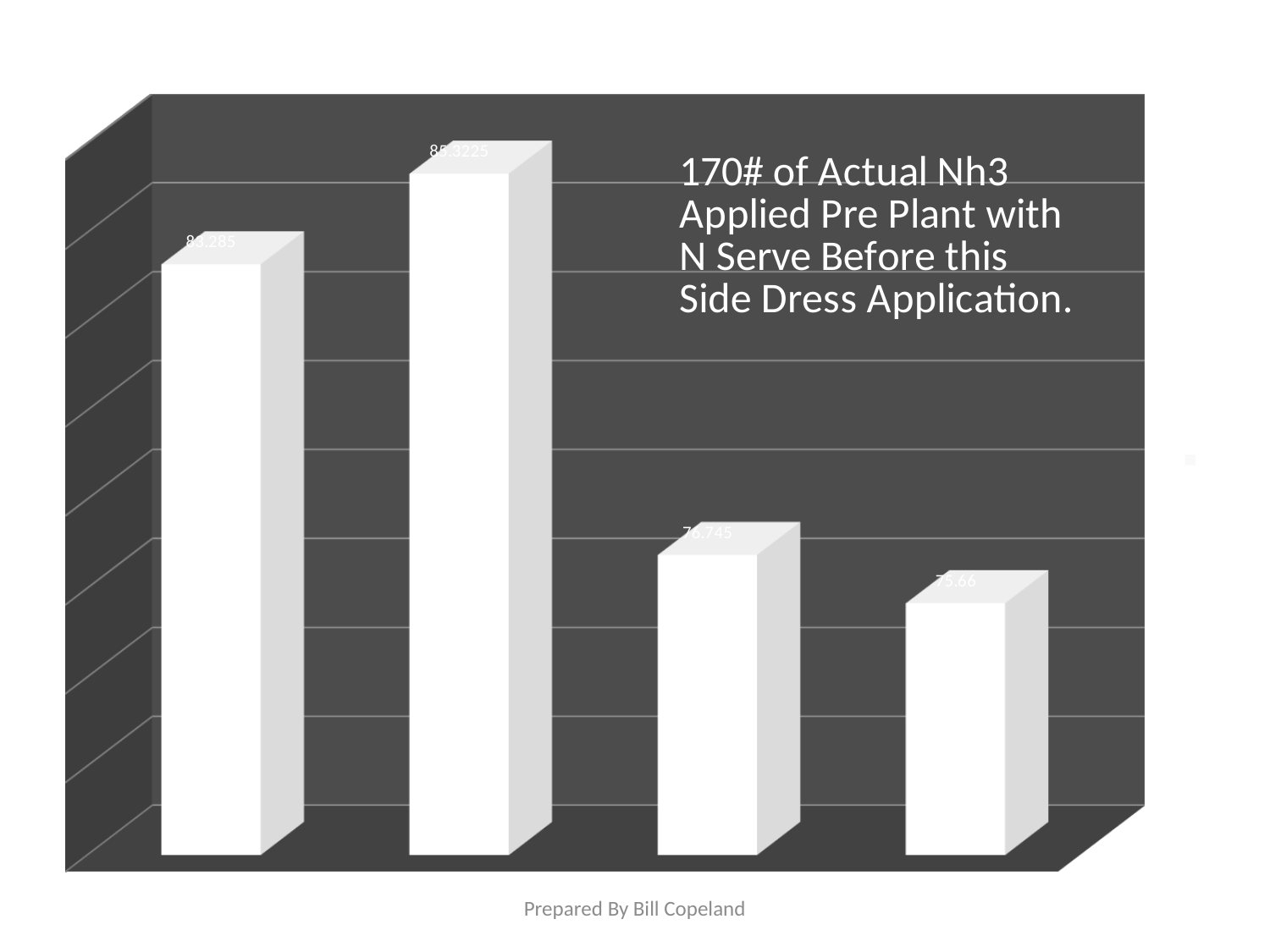
What is the value labelled on the second bar from the left? 85.3225 Which bar has the lowest value? The fourth bar from the left (75.66) What is the difference between the third bar (76.745) and the fourth bar (75.66)? 1.085 What is the value labelled on the third bar from the left? 76.745 What text is written inside the chart area to the right of the bars? 170# of Actual Nh3 Applied Pre Plant with N Serve Before this Side Dress Application. Which is larger, the value of the first bar or the value of the second bar? The second bar (85.3225) What is the difference between the second bar (85.3225) and the third bar (76.745)? 8.5775 What is the value labelled on the fourth bar from the left? 75.66 What kind of chart is shown on the slide? Bar chart How many bars are plotted in the chart? 4 Which is larger, the value of the third bar or the value of the fourth bar? The third bar (76.745) Which bar has the highest value? The second bar from the left (85.3225)